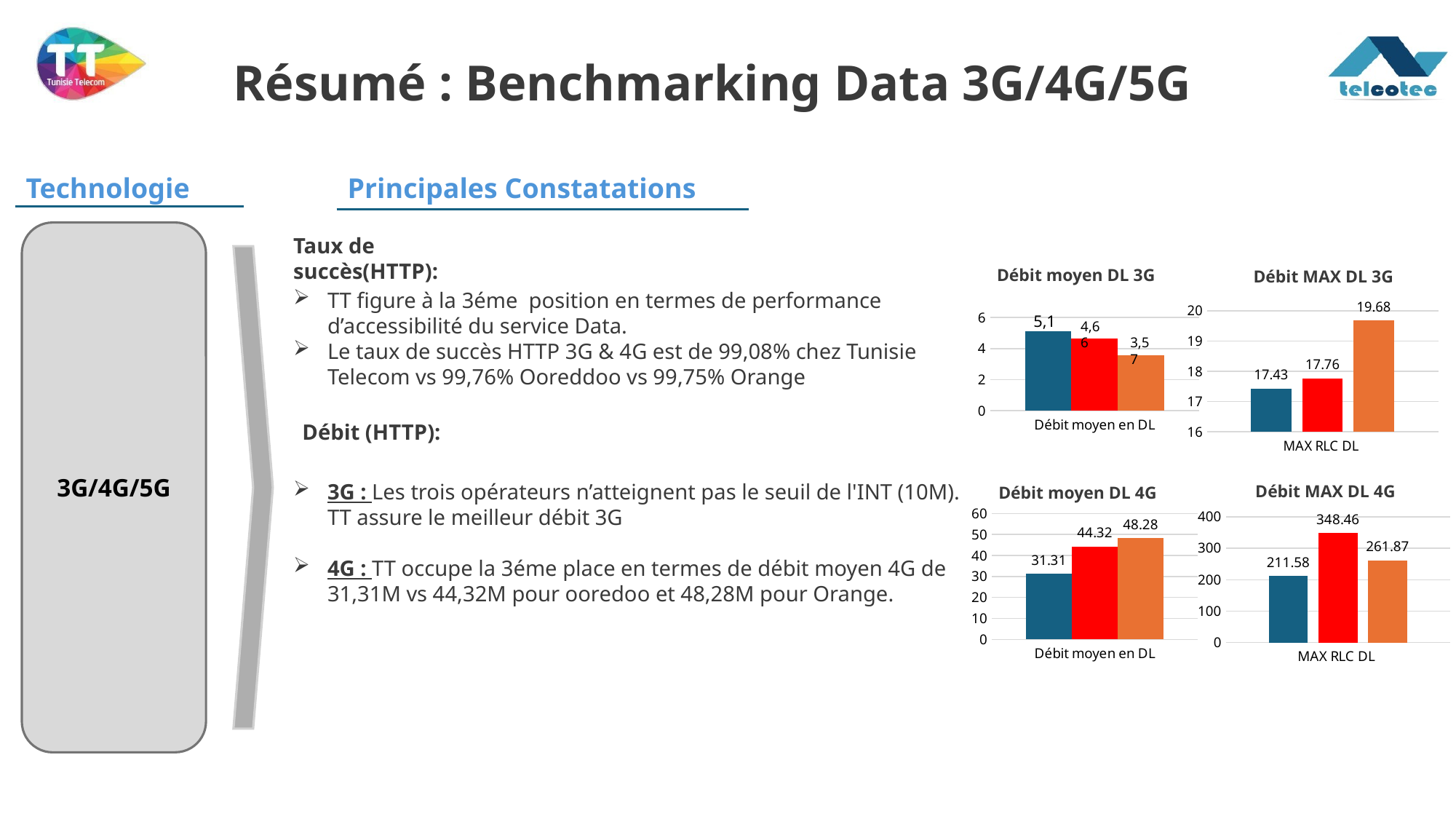
In the 'Débit moyen DL 4G' chart, what is the value of the red bar? 44.32 How many bars are shown in the 'Débit MAX DL 4G' chart? 3 In the 'Débit MAX DL 3G' chart, what is the value of the orange bar? 19.68 In the 'Débit MAX DL 3G' chart, is the red bar or the orange bar larger? Orange In the 'Débit MAX DL 3G' chart, what is the value of the blue bar? 17.43 What type of chart is 'Débit moyen DL 4G'? Bar chart In the 'Débit moyen DL 4G' chart, what is the difference between the orange bar and the blue bar? 16.97 In the 'Débit MAX DL 4G' chart, what is the difference between the red bar and the orange bar? 86.59 In the 'Débit MAX DL 4G' chart, what is the value of the blue bar? 211.58 In the 'Débit moyen DL 4G' chart, which bar colour has the lowest value? Blue In the 'Débit moyen DL 3G' chart, is the value of the orange bar greater or less than 4? less In the 'Débit MAX DL 4G' chart, which bar colour has the highest value? Red